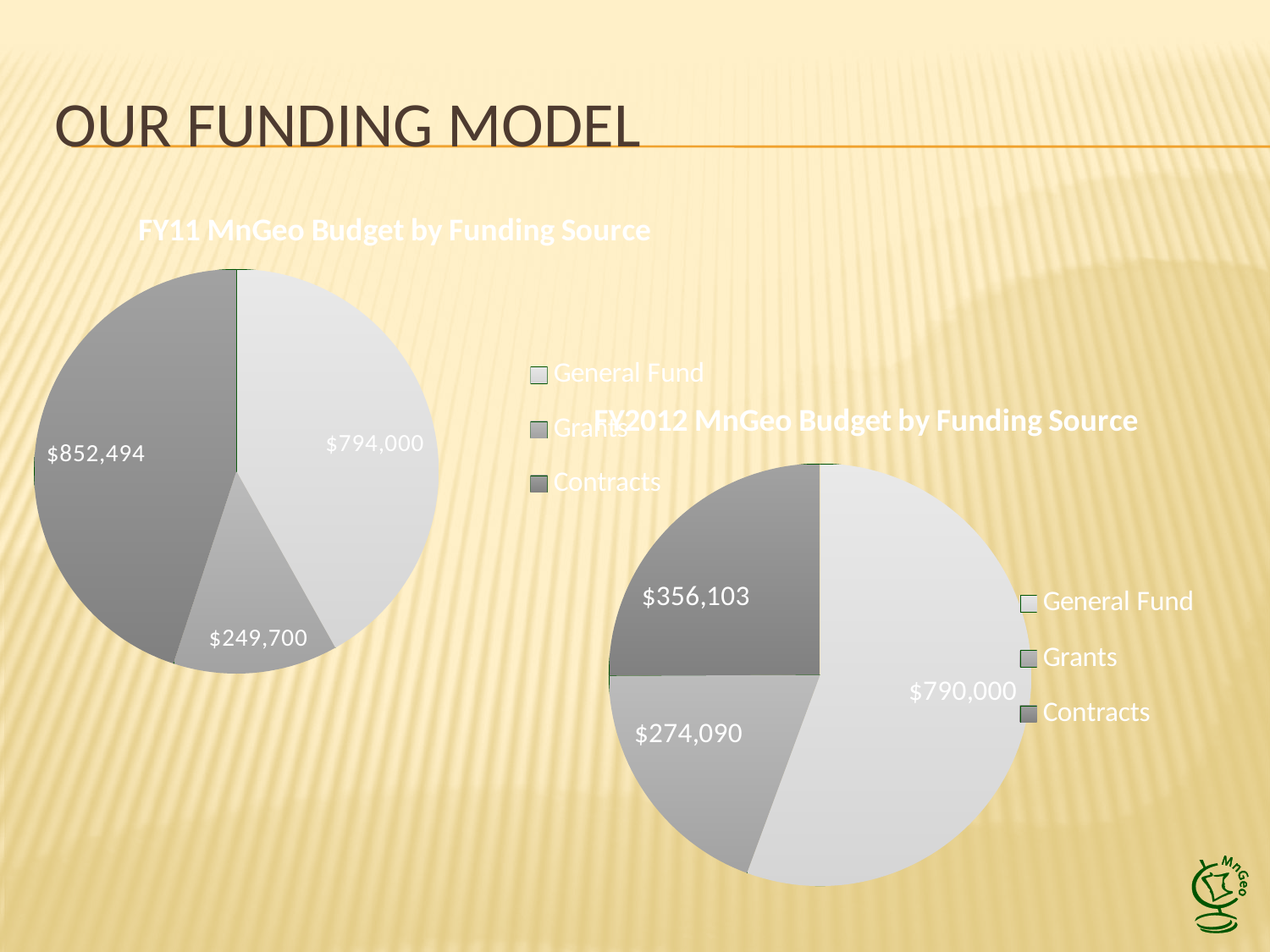
In the FY2012 MnGeo Budget by Funding Source chart, which is larger, General Fund or Contracts? General Fund In the FY2012 MnGeo Budget by Funding Source chart, what is the value for Contracts? $356,103 In the FY11 MnGeo Budget by Funding Source chart, which funding source has the largest value? Contracts How many entries does the legend of the FY11 MnGeo Budget by Funding Source chart list? 3 In the FY2012 MnGeo Budget by Funding Source chart, what is the value for General Fund? $790,000 In the FY11 MnGeo Budget by Funding Source chart, what is the value for Contracts? $852,494 What is the difference between the Grants value in the FY2012 chart and the Grants value in the FY11 chart? $24,390 How many slices does the FY2012 MnGeo Budget by Funding Source pie chart have? 3 What kind of chart is the FY11 MnGeo Budget by Funding Source chart? pie chart In the FY2012 MnGeo Budget by Funding Source chart, which funding source has the smallest value? Grants In the FY11 MnGeo Budget by Funding Source chart, what is the value for Grants? $249,700 In the FY11 MnGeo Budget by Funding Source chart, what is the difference between Contracts and General Fund? $58,494